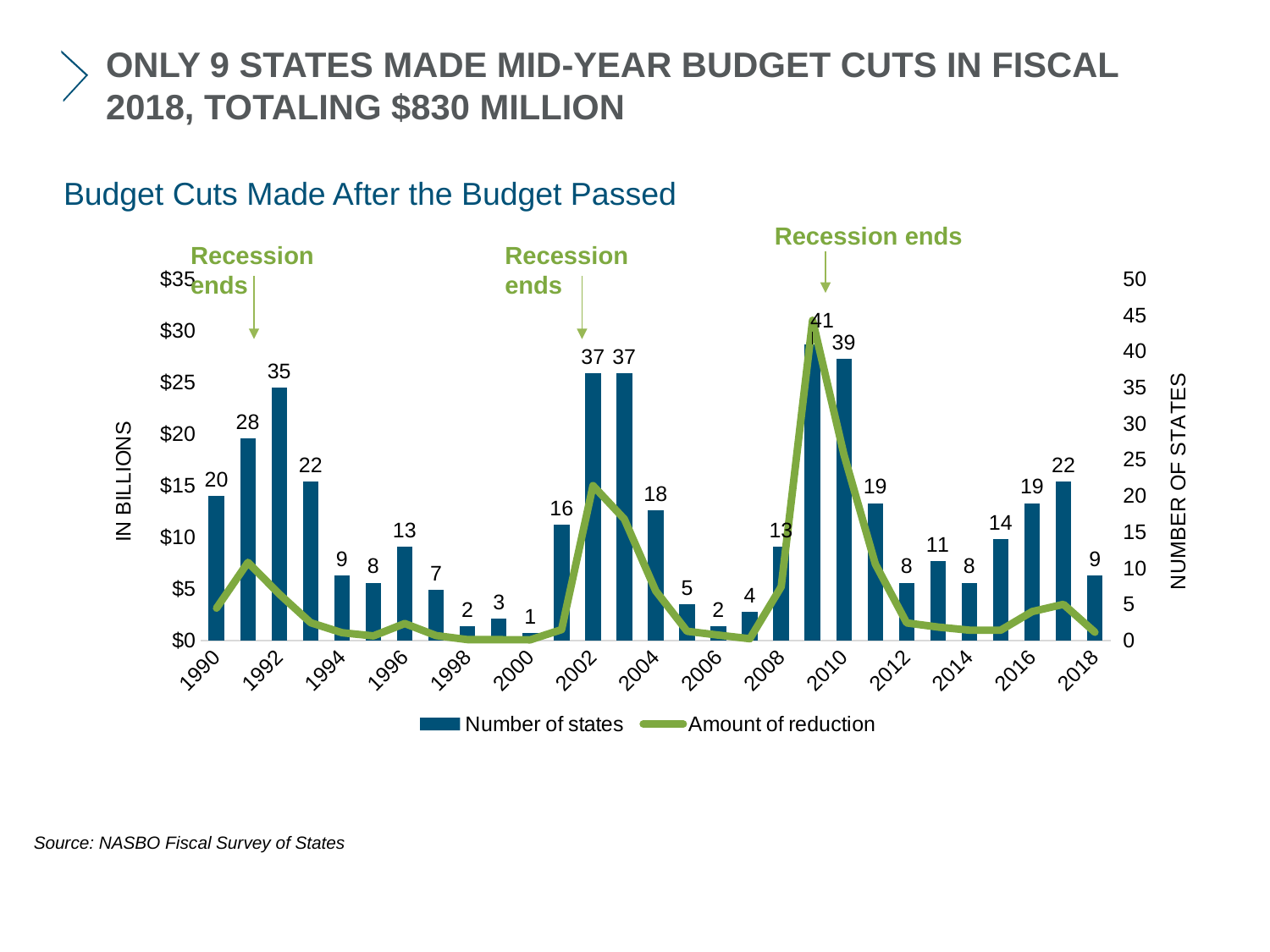
Is the amount of reduction for 2018 greater or less than $5 billion? less What is the number of states shown for 1992? 35 What is the number of states shown for 2002? 37 How many states made budget cuts after the budget passed in 2000? 1 What kind of chart is shown on the slide? Combined bar and line chart Which labeled year has the lowest number of states? 2000 What is the number of states shown for 2018? 9 Is the amount of reduction for 2010 greater or less than $10 billion? greater Which year had more states making cuts, 2016 or 2014? 2016 What is the difference in the number of states between 2010 and 2012? 31 How many series does the legend list? 2 What is the highest number of states shown by any bar in the chart? 41